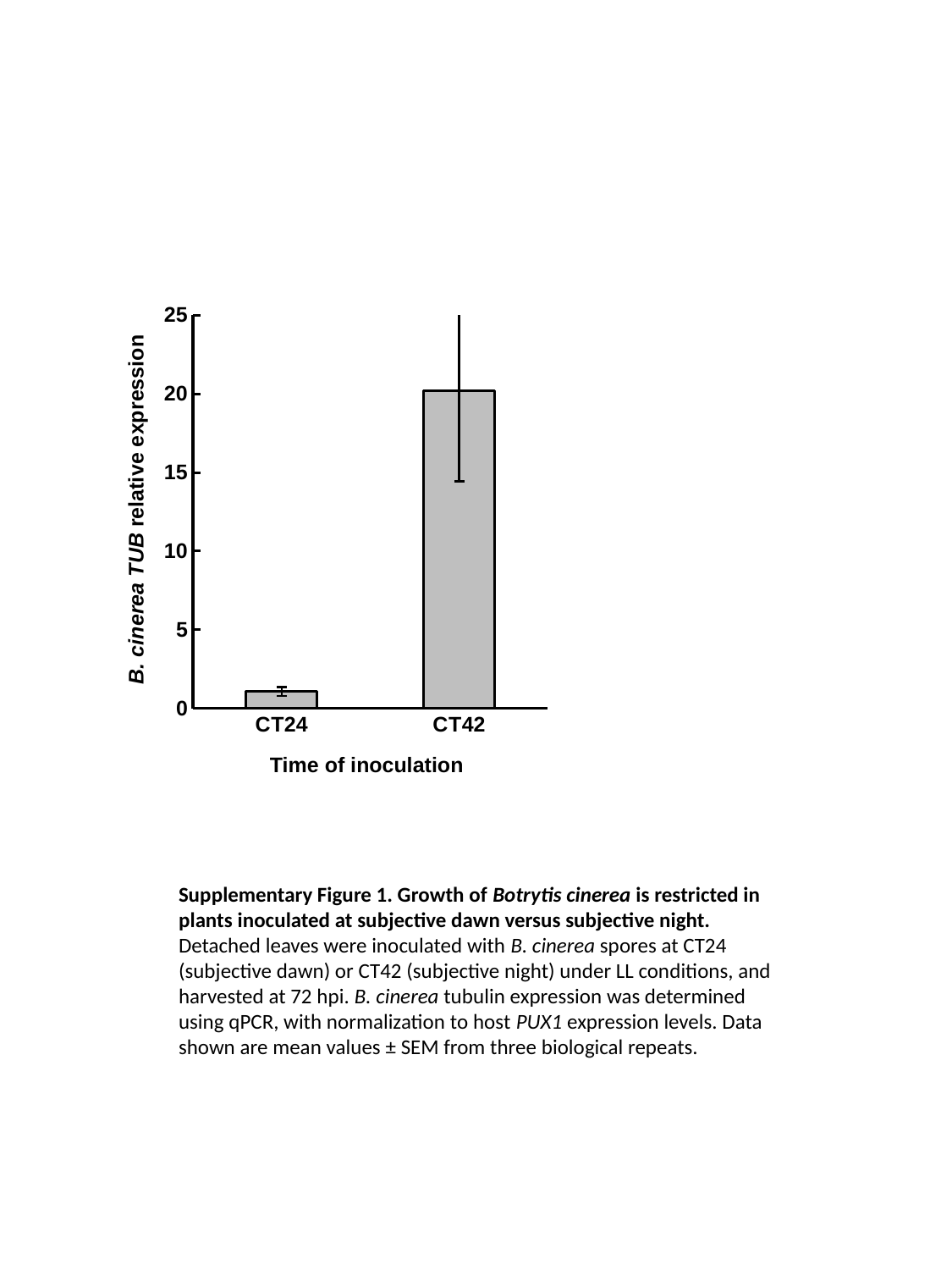
Which has a larger B. cinerea TUB relative expression, CT24 or CT42? CT42 What is the label of the x axis? Time of inoculation Which time of inoculation has the highest B. cinerea TUB relative expression? CT42 Which time of inoculation has the lowest B. cinerea TUB relative expression? CT24 Is the value for CT42 greater or less than 25? less What is the label of the y axis? B. cinerea TUB relative expression Is the value for CT42 greater or less than 15? greater How many categories are shown on the x axis? 2 What kind of chart is shown on the slide? bar chart Do the values rise or fall from CT24 to CT42? rise Is the value for CT24 greater or less than 5? less